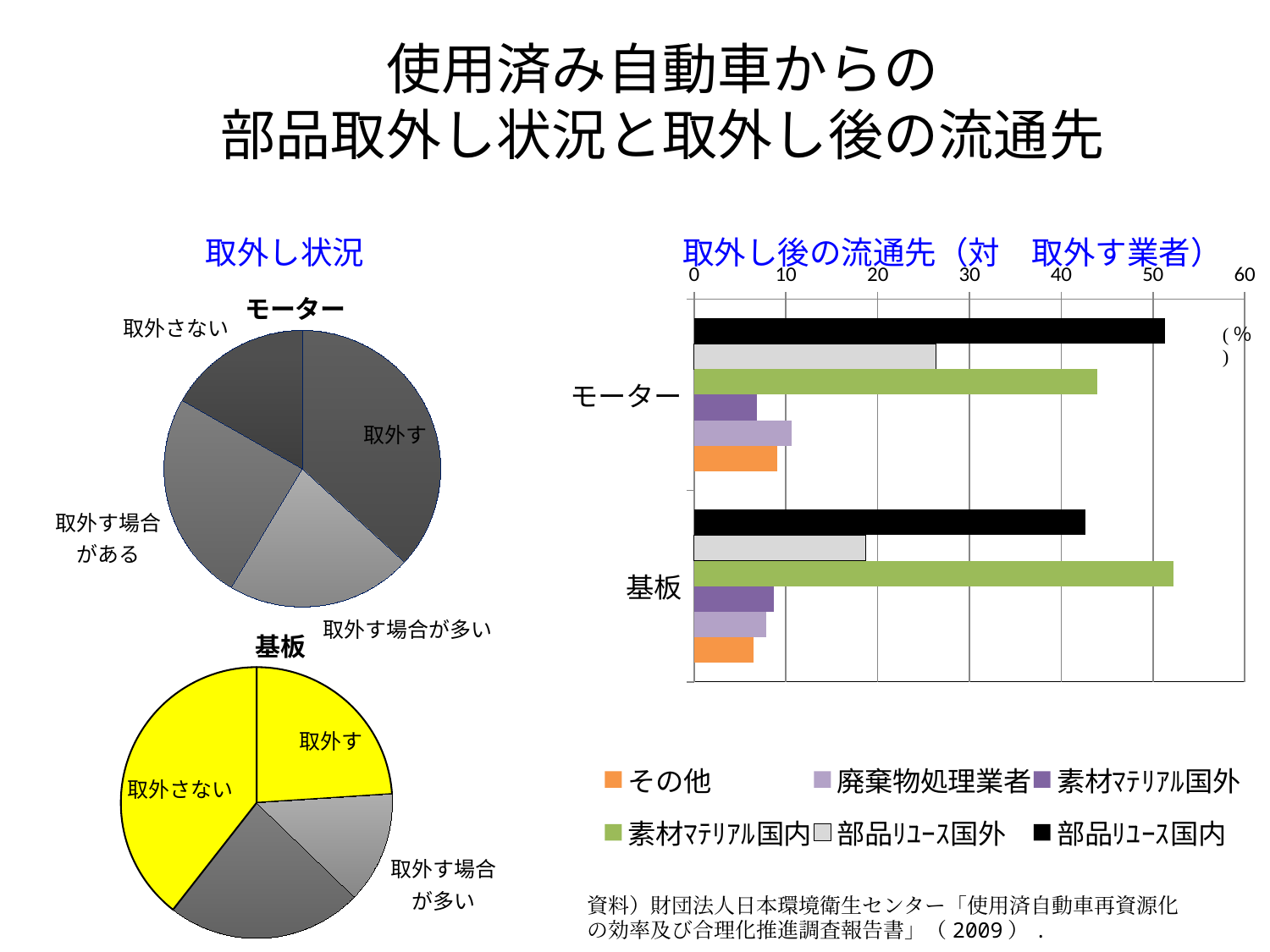
How many series does the legend of the 取外し後の流通先 chart list? 6 In the 取外し後の流通先 chart, which series has the longest bar for 基板? 素材マテリアル国内 How many categories are shown on the vertical axis of the 取外し後の流通先 bar chart? 2 In the 取外し後の流通先 chart, is the その他 value for モーター greater or less than 10? less In the 取外し後の流通先 chart, which series has the longest bar for モーター? 部品リユース国内 In the 取外し後の流通先 chart, is the 部品リユース国外 value for 基板 greater or less than 20? less In the 基板 pie chart, which slice is the largest? 取外さない How many slices does the 基板 pie chart have? 4 What kind of chart is the 取外し後の流通先 chart on the right? bar chart In the 取外し後の流通先 chart, is the 部品リユース国内 value for モーター greater or less than 40? greater What kind of chart is the モーター chart under 取外し状況? pie chart In the 取外し後の流通先 chart, which is larger: the 素材マテリアル国内 value for モーター or for 基板? 基板